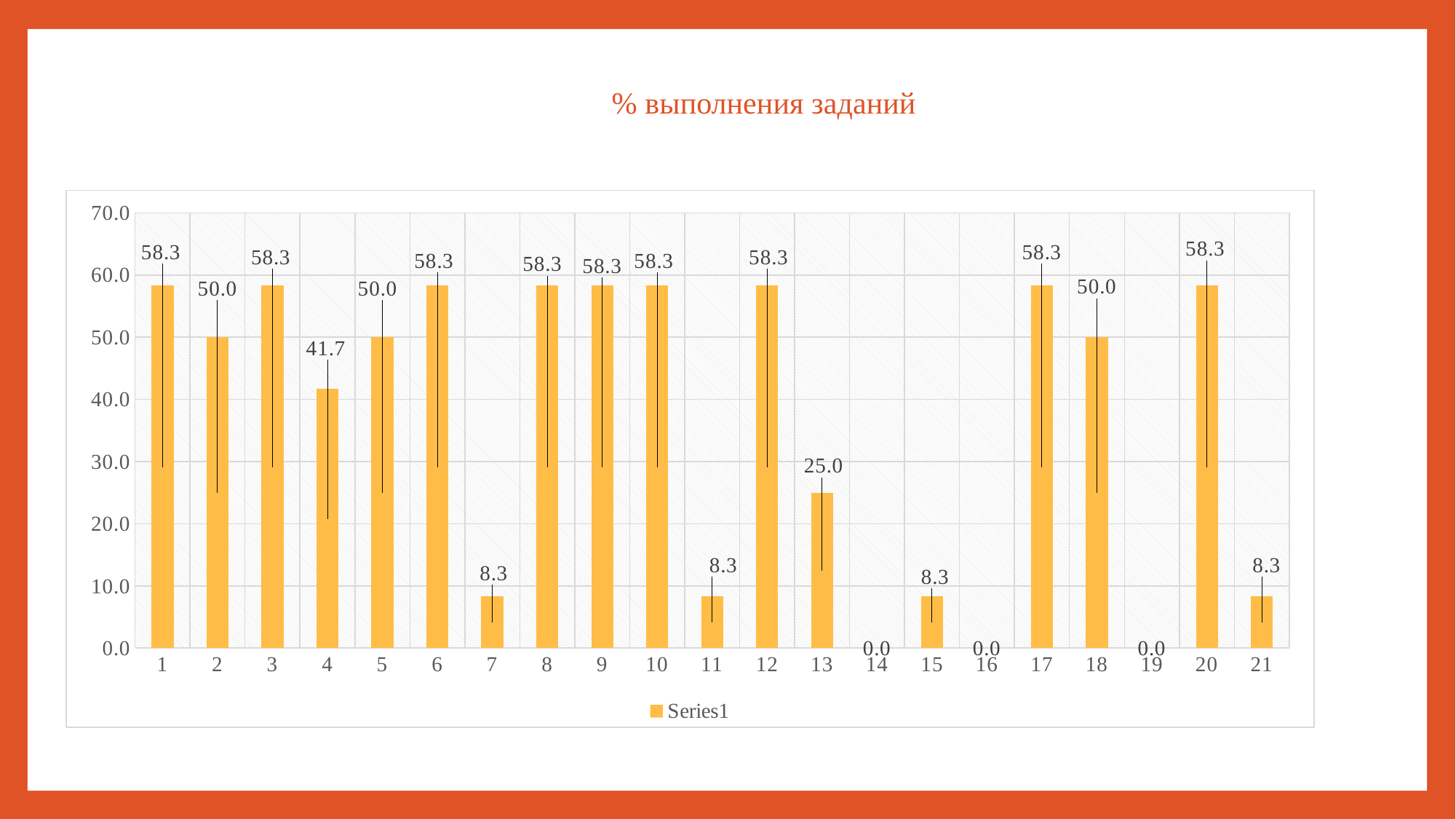
What is the value for category 18? 50.0 What kind of chart is shown on the slide? bar chart What is the value for category 13? 25.0 What is the value for category 16? 0.0 What is the difference between the values for category 13 and category 15? 16.7 Which has a larger value, category 2 or category 13? category 2 What is the difference between the values for category 1 and category 4? 16.6 Which has a larger value, category 7 or category 4? category 4 How many categories are shown on the x axis? 21 What is the value for category 21? 8.3 What is the title of the chart? % выполнения заданий What is the value for category 4? 41.7